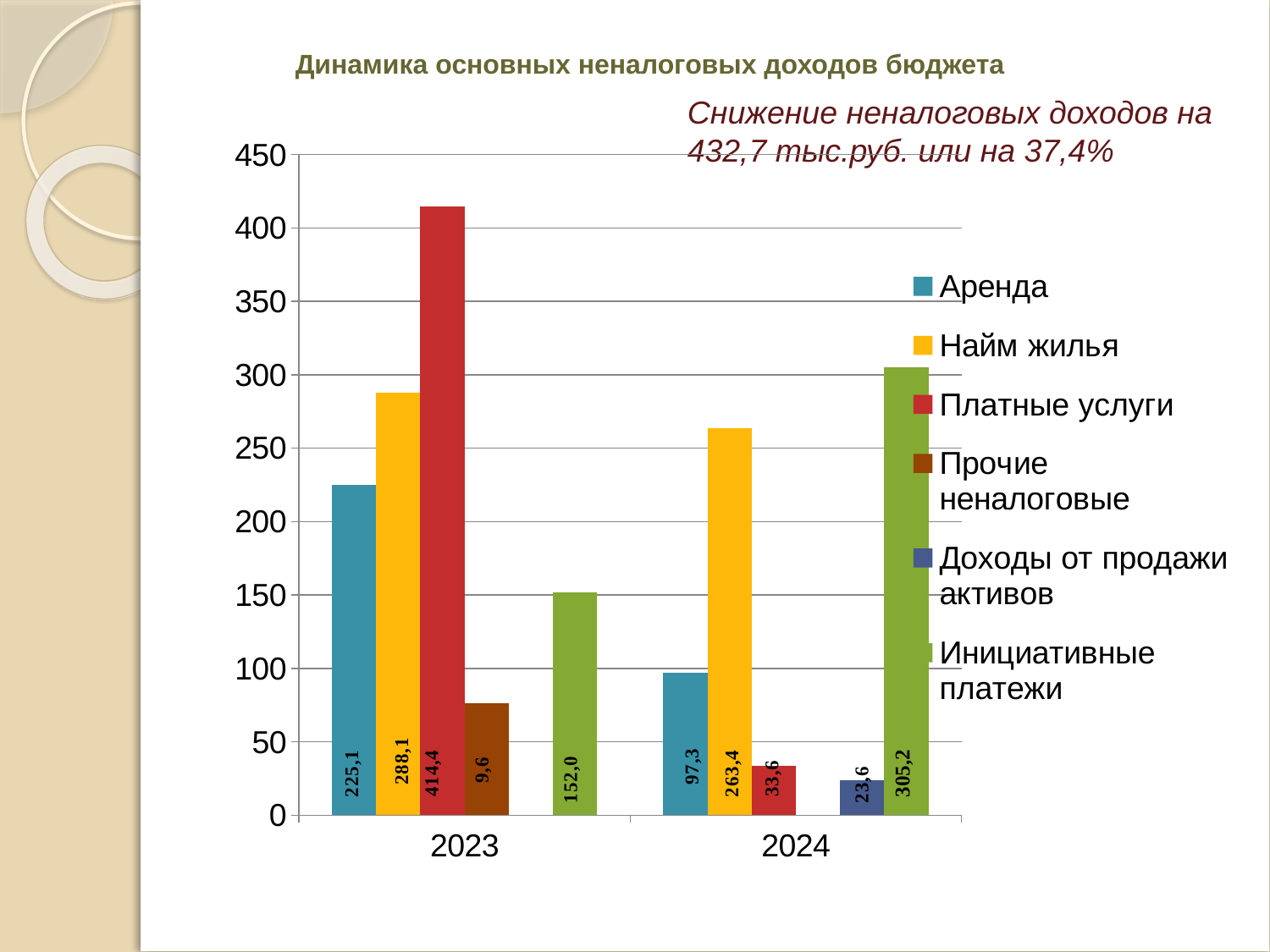
What kind of chart is shown on the slide? bar chart How many year categories are shown on the x axis? 2 What is the value for Инициативные платежи in 2024? 305,2 What is the value for Платные услуги in 2023? 414,4 What is the value for Аренда in 2023? 225,1 What is the difference between the Найм жилья values for 2023 and 2024? 24,7 What is the title of the chart? Динамика основных неналоговых доходов бюджета Which series has the highest value in 2023? Платные услуги How many series does the legend list? 6 What is the value for Доходы от продажи активов in 2024? 23,6 Which is larger: Аренда in 2023 or Аренда in 2024? Аренда in 2023 Which series has the highest value in 2024? Инициативные платежи